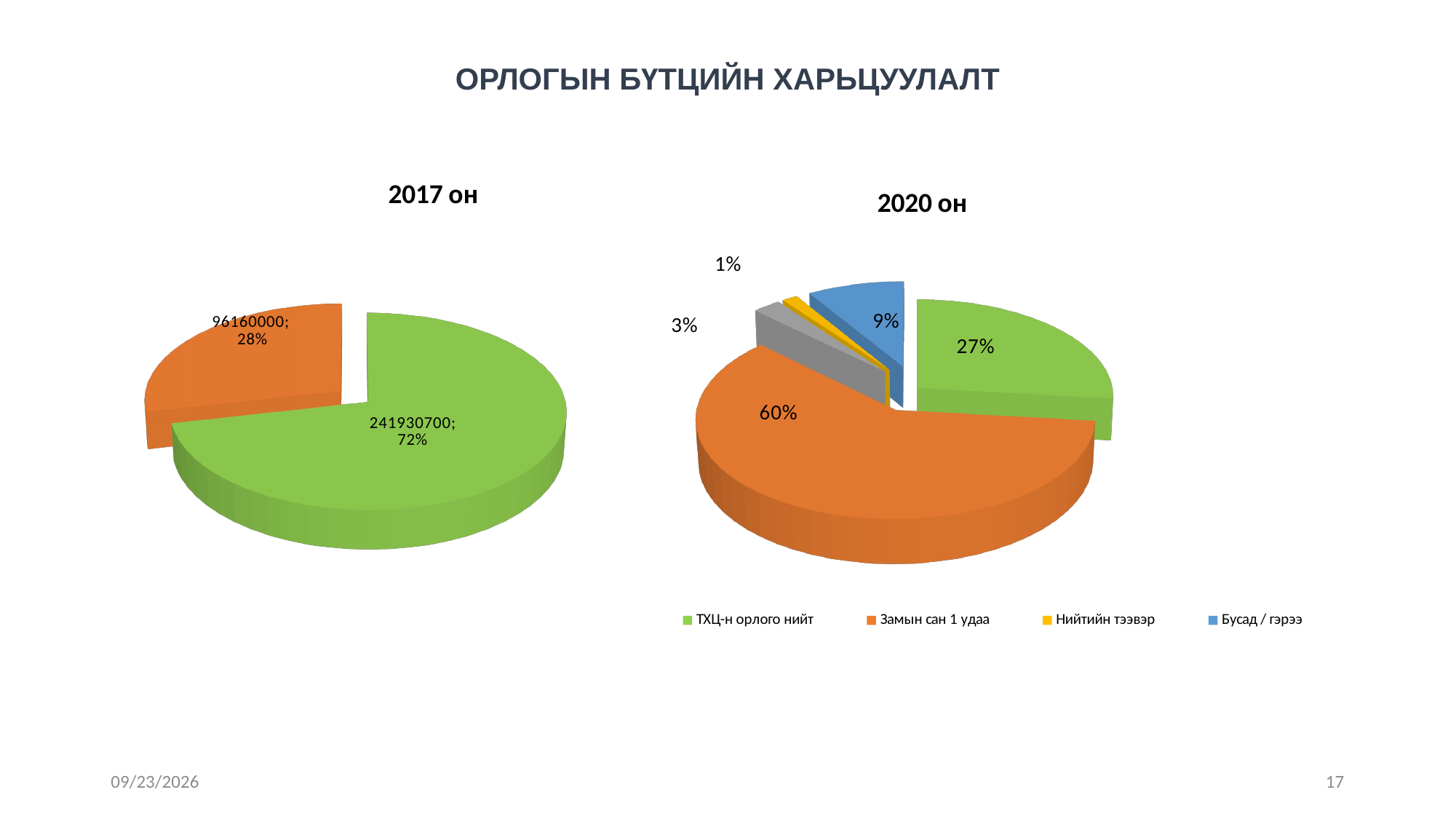
In the 2017 он pie chart, what value is shown for Замын сан 1 удаа? 96160000 In the 2017 он pie chart, what value is shown for ТХЦ-н орлого нийт? 241930700 In the 2020 он pie chart, which category has the largest slice? Замын сан 1 удаа In the 2020 он pie chart, what share does Бусад / гэрээ take? 9% In the 2017 он pie chart, which slice is larger: ТХЦ-н орлого нийт or Замын сан 1 удаа? ТХЦ-н орлого нийт What kind of charts are shown on the slide? Pie charts In the 2020 он pie chart, how many slices does the pie have? 5 How many entries does the legend on the slide list? 4 In the 2020 он pie chart, what share does Замын сан 1 удаа take? 60% In the 2017 он pie chart, what share of the pie does Замын сан 1 удаа take? 28% In the 2017 он pie chart, what is the difference between the ТХЦ-н орлого нийт value and the Замын сан 1 удаа value? 145770700